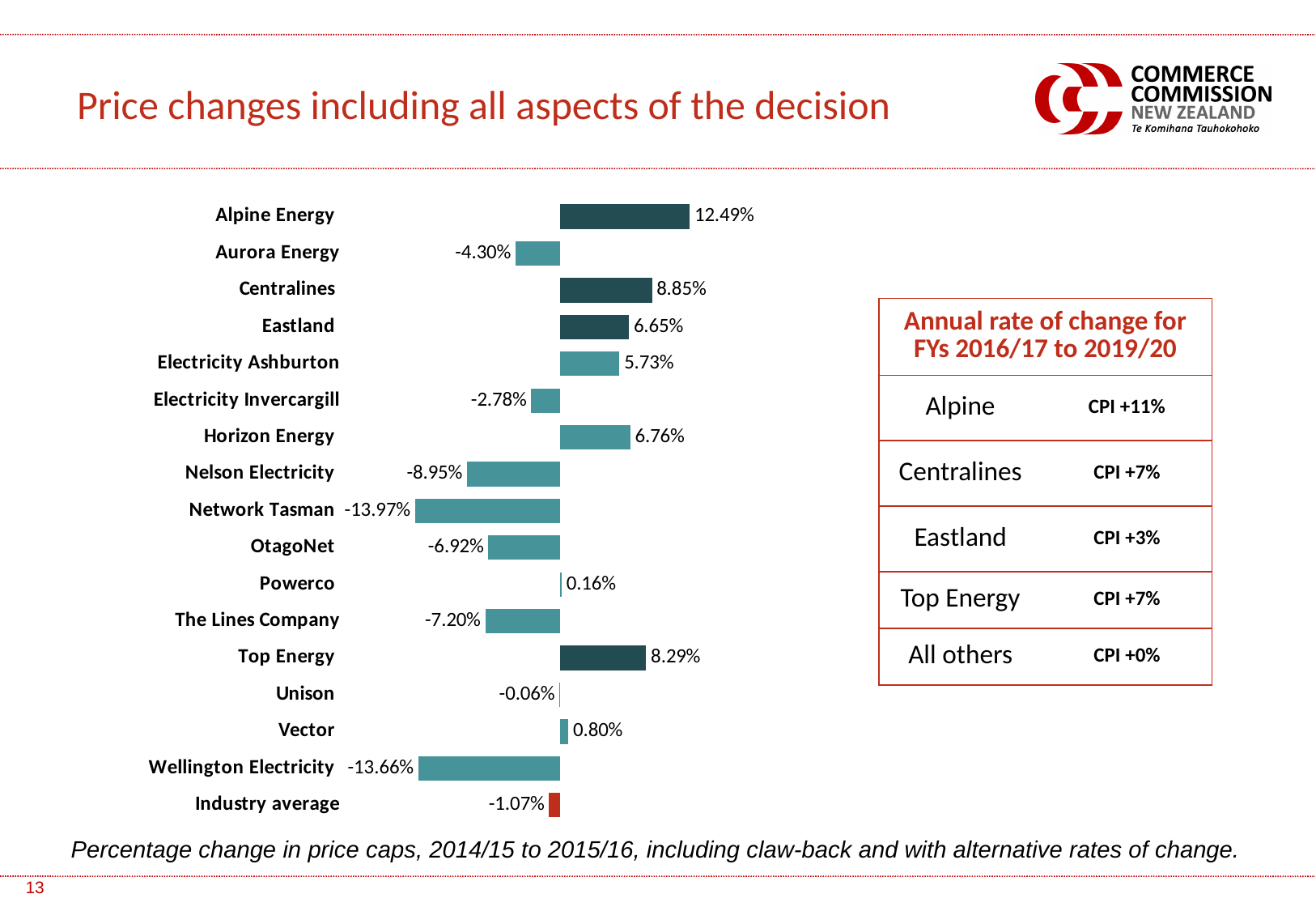
Which bar in the chart is coloured red? Industry average What is the price change shown for Alpine Energy? 12.49% Which category has the highest price change? Alpine Energy What is the difference between the values for Network Tasman and Wellington Electricity? 0.31 percentage points Which has the larger price change, Top Energy or Electricity Ashburton? Top Energy What is the price change shown for Wellington Electricity? -13.66% How many bars (categories) are shown in the chart? 17 What is the value shown for the Industry average? -1.07% What is the difference between the values for Alpine Energy and Centralines? 3.64 percentage points What kind of chart is shown on the slide? Bar chart Which category has the lowest price change? Network Tasman What is the price change shown for Network Tasman? -13.97%